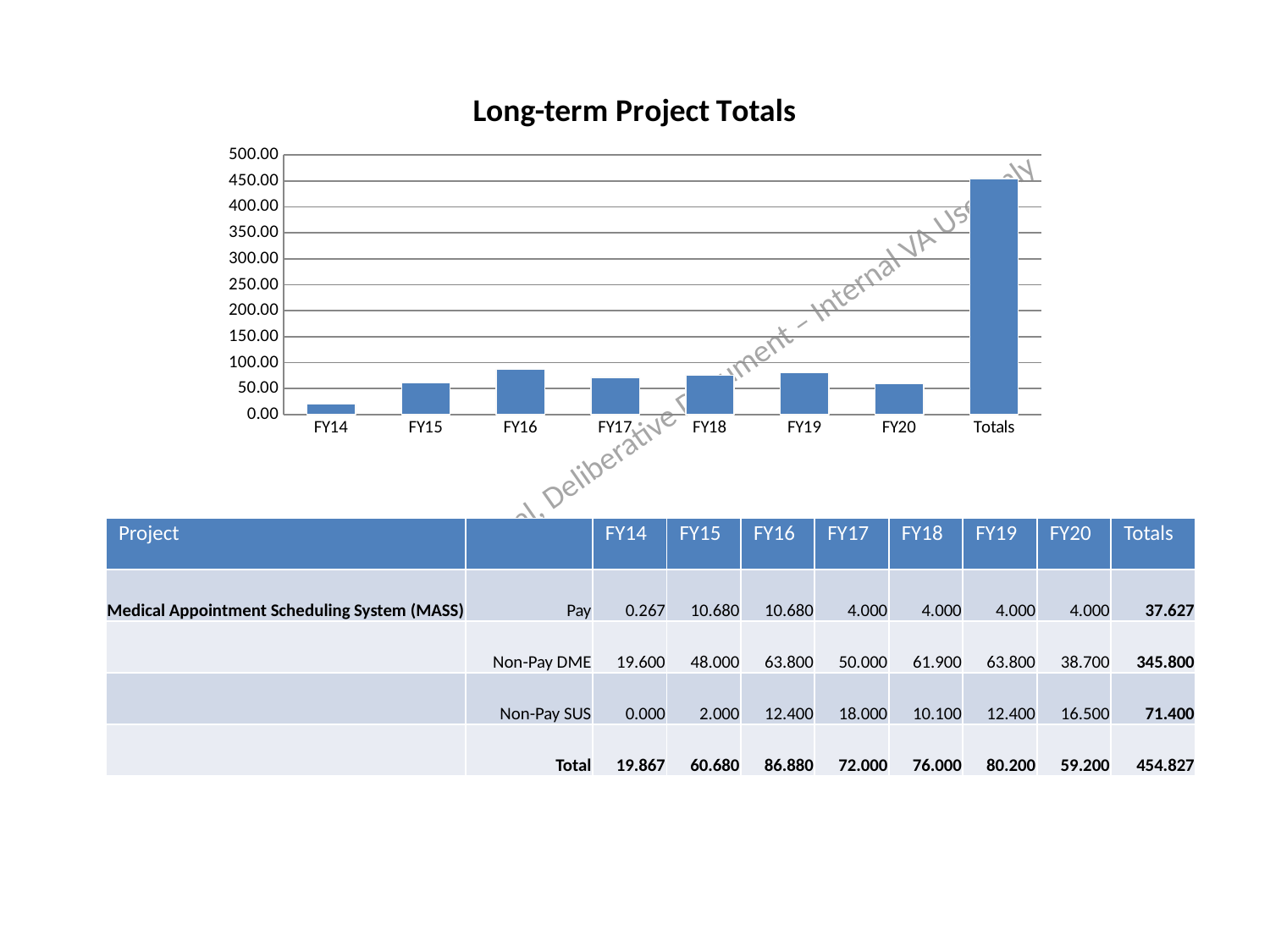
What is the title of the chart? Long-term Project Totals Is the value for FY16 greater or less than 50.00? greater Is the value for FY20 greater or less than 100.00? less How many categories are shown on the x axis of the chart? 8 Which bar is taller, FY16 or FY20? FY16 What kind of chart is shown on the slide? bar chart Is the value for FY14 greater or less than 50.00? less Which category has the shortest bar in the chart? FY14 Do the bars rise or fall from FY14 to FY16? rise Which category has the tallest bar in the chart? Totals Which bar is taller, FY15 or FY18? FY18